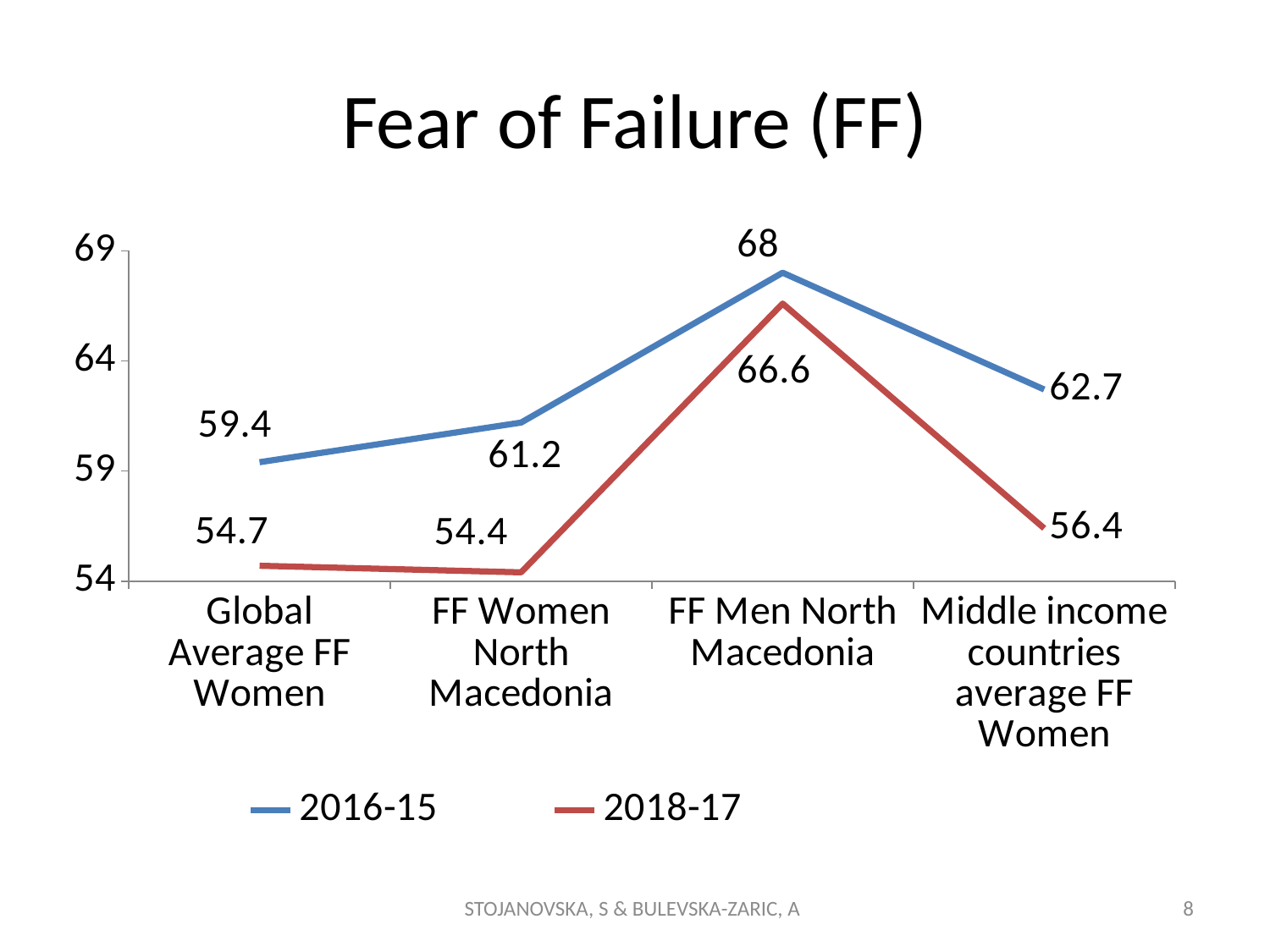
What kind of chart is shown on the slide? Line chart How many series does the legend list? 2 Which is larger for Middle income countries average FF Women: the 2016-15 value or the 2018-17 value? 2016-15 What is the 2018-17 value for FF Men North Macedonia? 66.6 How many categories are shown on the x axis? 4 What is the difference between the 2016-15 and 2018-17 values for FF Men North Macedonia? 1.4 What is the 2016-15 value for Global Average FF Women? 59.4 Which category has the highest 2016-15 value? FF Men North Macedonia What is the 2018-17 value for Middle income countries average FF Women? 56.4 What is the 2016-15 value for FF Women North Macedonia? 61.2 What is the title of the chart? Fear of Failure (FF) Which category has the lowest 2018-17 value? FF Women North Macedonia